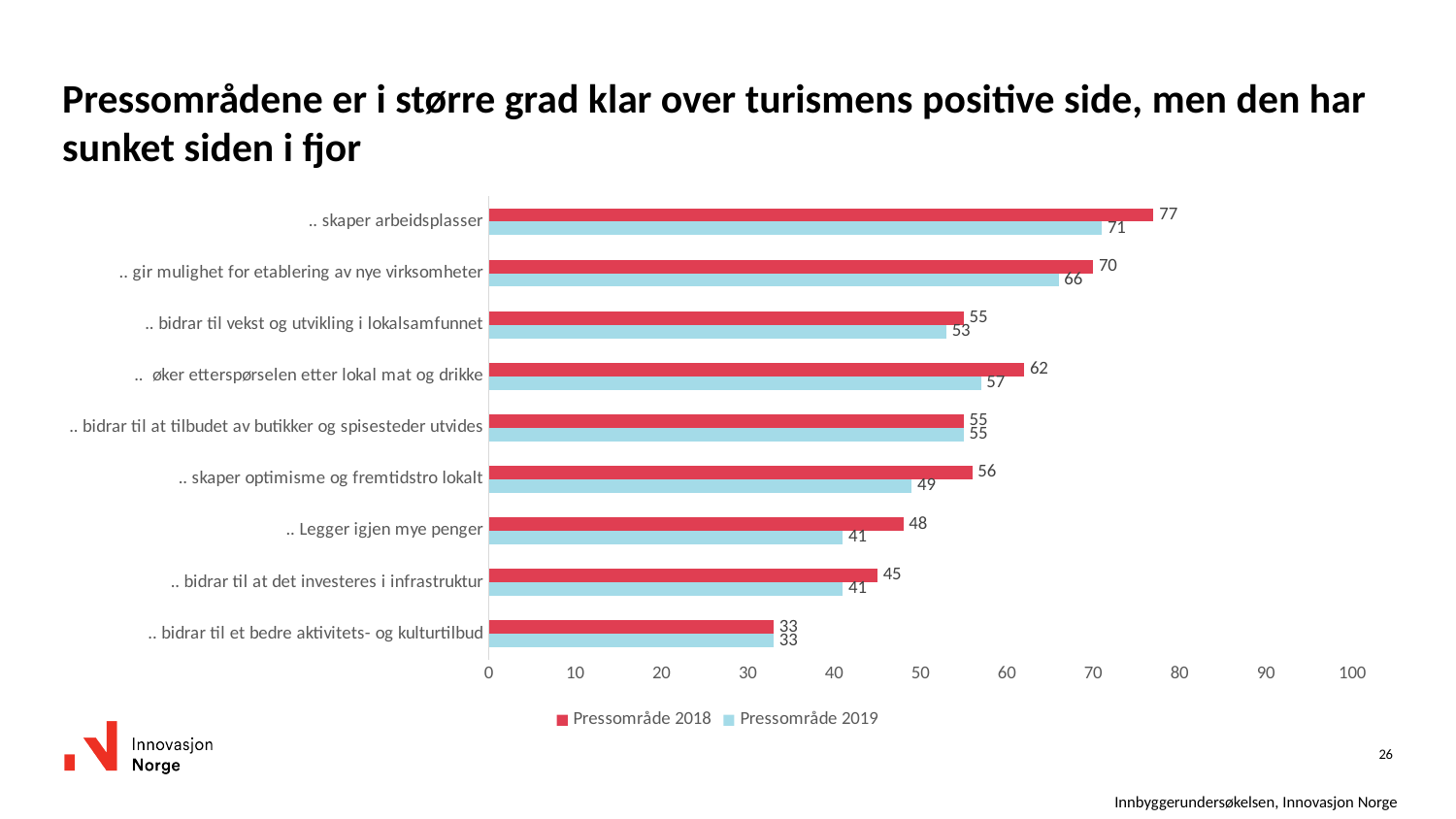
What is the value for "øker etterspørselen etter lokal mat og drikke" in the Pressområde 2019 series? 57 How many series does the legend list? 2 Which category has the highest value in the Pressområde 2018 series? .. skaper arbeidsplasser How many categories are shown on the chart? 9 What is the difference between the Pressområde 2018 and Pressområde 2019 values for "skaper optimisme og fremtidstro lokalt"? 7 Which colour represents the Pressområde 2019 series? light blue Is the Pressområde 2018 value for "bidrar til at det investeres i infrastruktur" greater or less than 40? greater What kind of chart is shown on the slide? bar chart What is the value for "Legger igjen mye penger" in the Pressområde 2019 series? 41 Which category has the lowest value in the Pressområde 2019 series? .. bidrar til et bedre aktivitets- og kulturtilbud What is the value for "skaper arbeidsplasser" in the Pressområde 2018 series? 77 Which is larger for "gir mulighet for etablering av nye virksomheter": the Pressområde 2018 value or the Pressområde 2019 value? Pressområde 2018